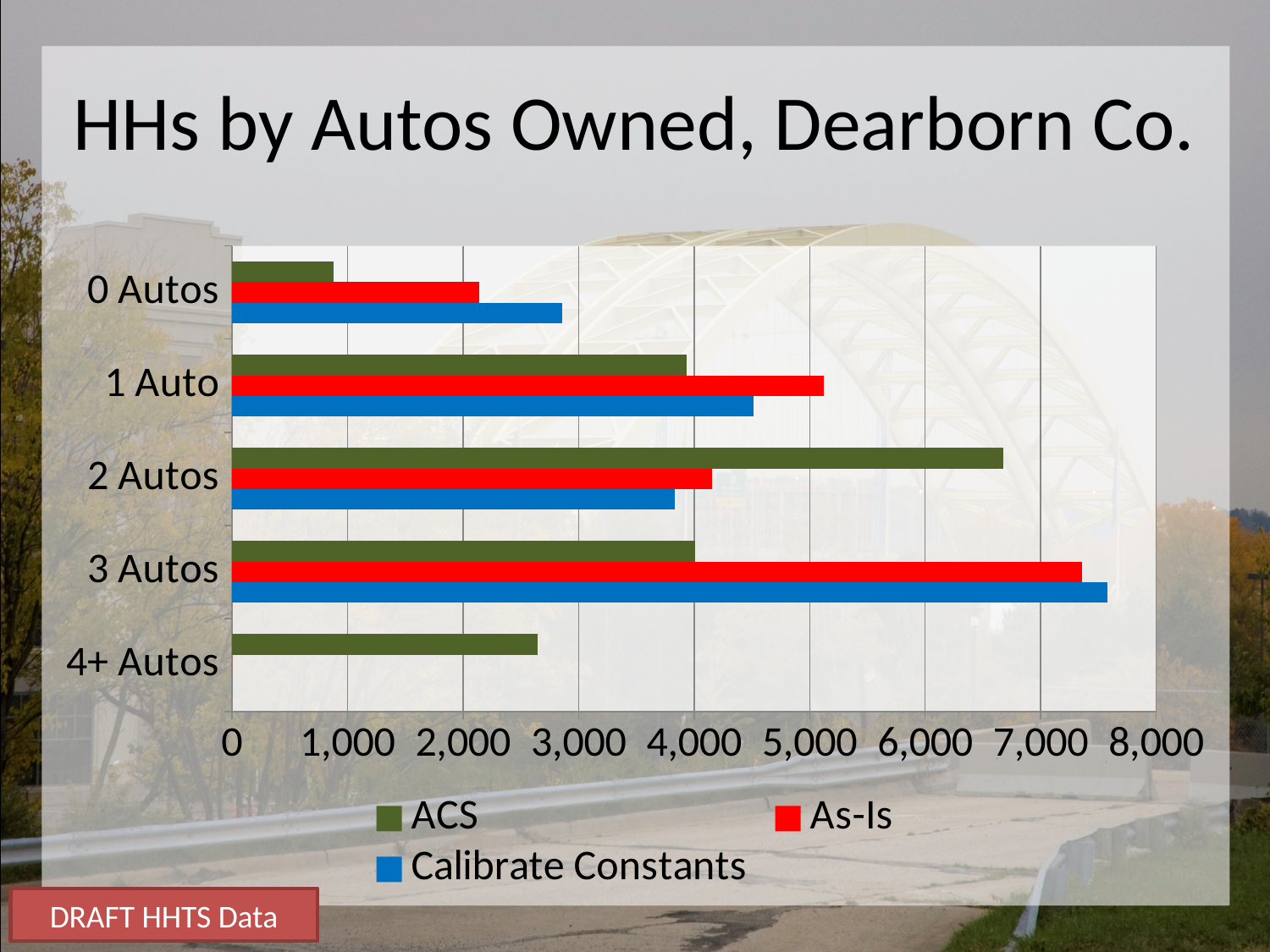
For 2 Autos, which series has the larger value, ACS or As-Is? ACS Which category has the highest Calibrate Constants value? 3 Autos Is the ACS value for 2 Autos greater or less than 6,000? greater How many auto-ownership categories are shown on the chart? 5 Is the ACS value for 0 Autos greater or less than 1,000? less What is the title of the chart? HHs by Autos Owned, Dearborn Co. Which category has the highest As-Is value? 3 Autos Which category has the highest ACS value? 2 Autos Which category has the lowest ACS value? 0 Autos For 1 Auto, which series has the larger value, As-Is or Calibrate Constants? As-Is What kind of chart is shown on the slide? Bar chart How many series does the legend list? 3